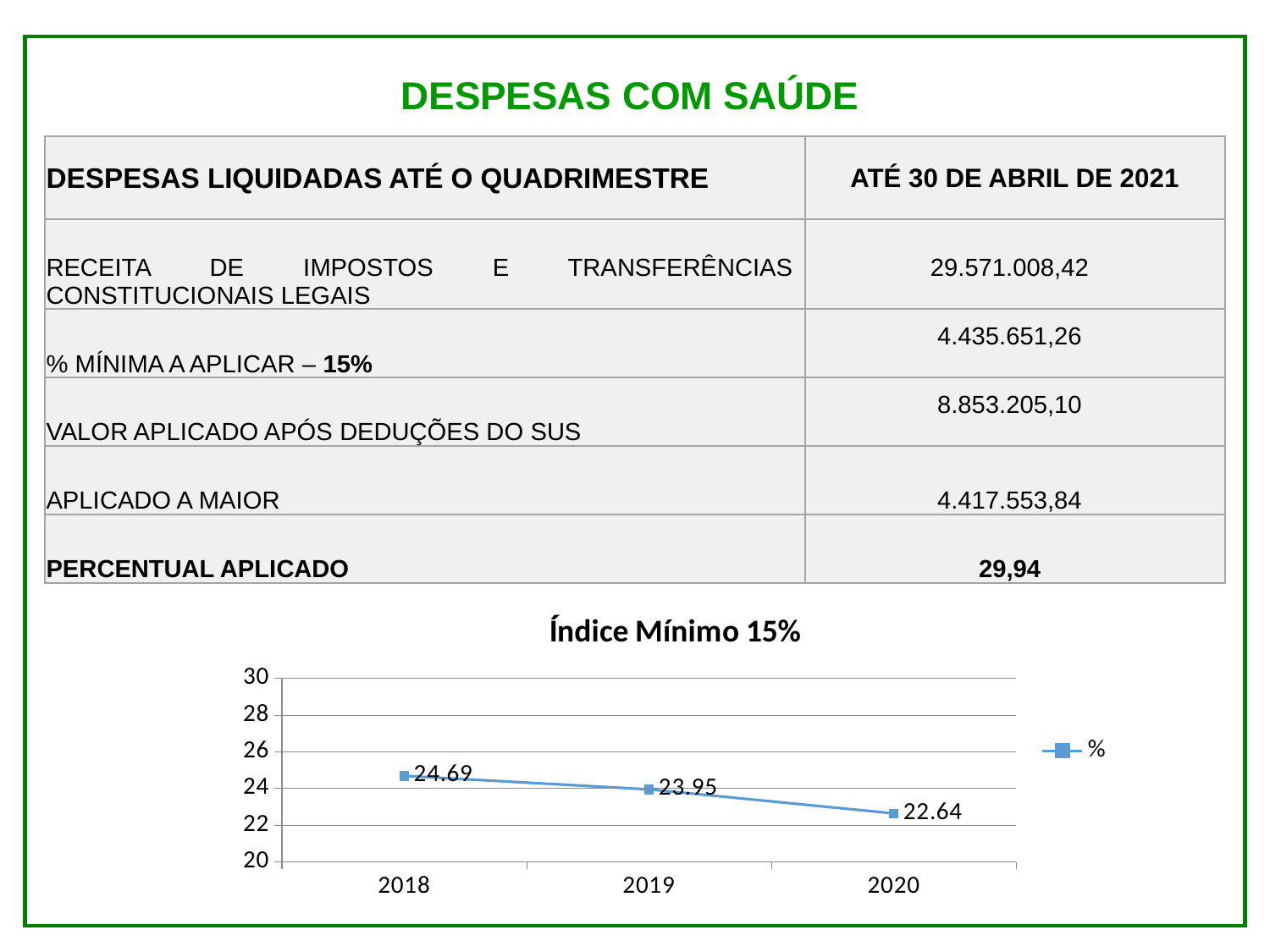
What is the difference between the values for 2018 and 2020? 2.05 What is the value for 2020 in the chart? 22.64 Do the values rise or fall from 2018 to 2020? fall What is the value for 2018 in the chart? 24.69 Which year has the lowest value in the chart? 2020 Which is larger, the value for 2019 or the value for 2020? 2019 Is the value for 2020 greater or less than 24? less How many years are plotted on the x axis of the chart? 3 What is the value for 2019 in the chart? 23.95 Which year has the highest value in the chart? 2018 What is the difference between the values for 2018 and 2019? 0.74 What kind of chart is shown on the slide? line chart